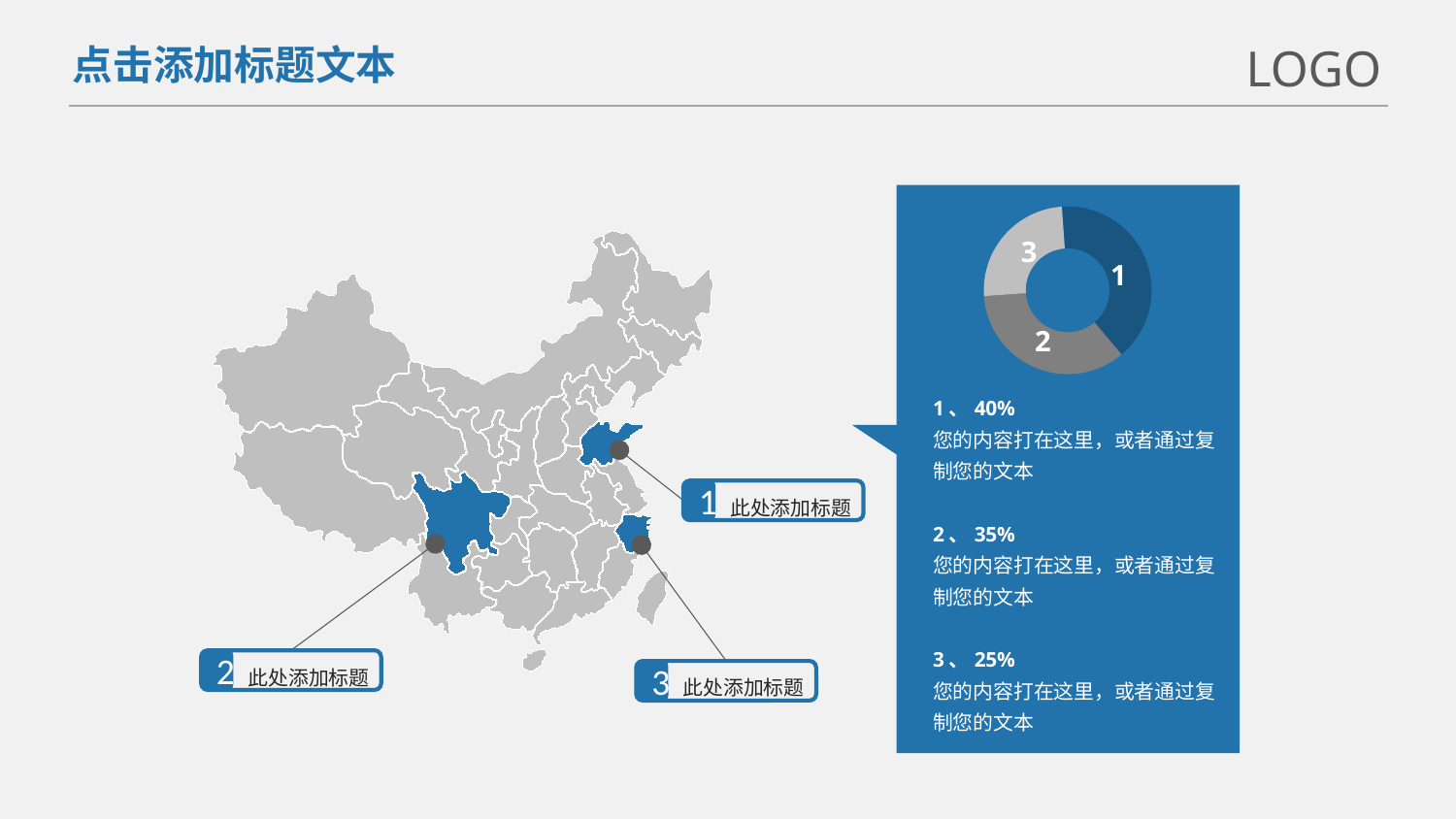
What do the three listed percentages add up to? 100% What is the difference between the percentages for segment 2 and segment 3? 10% Which is larger, the share for segment 1 or segment 2? Segment 1 Which segment of the donut chart has the smallest share? 3 Which segment of the donut chart is drawn in the lightest grey? 3 What is the difference between the percentages for segment 1 and segment 3? 15% Which segment of the donut chart has the largest share? 1 How many segments does the donut chart have? 3 What percentage is listed for segment 3? 25% What percentage is listed for segment 1? 40% What percentage is listed for segment 2? 35% What kind of chart is shown on the slide? Pie chart (donut)